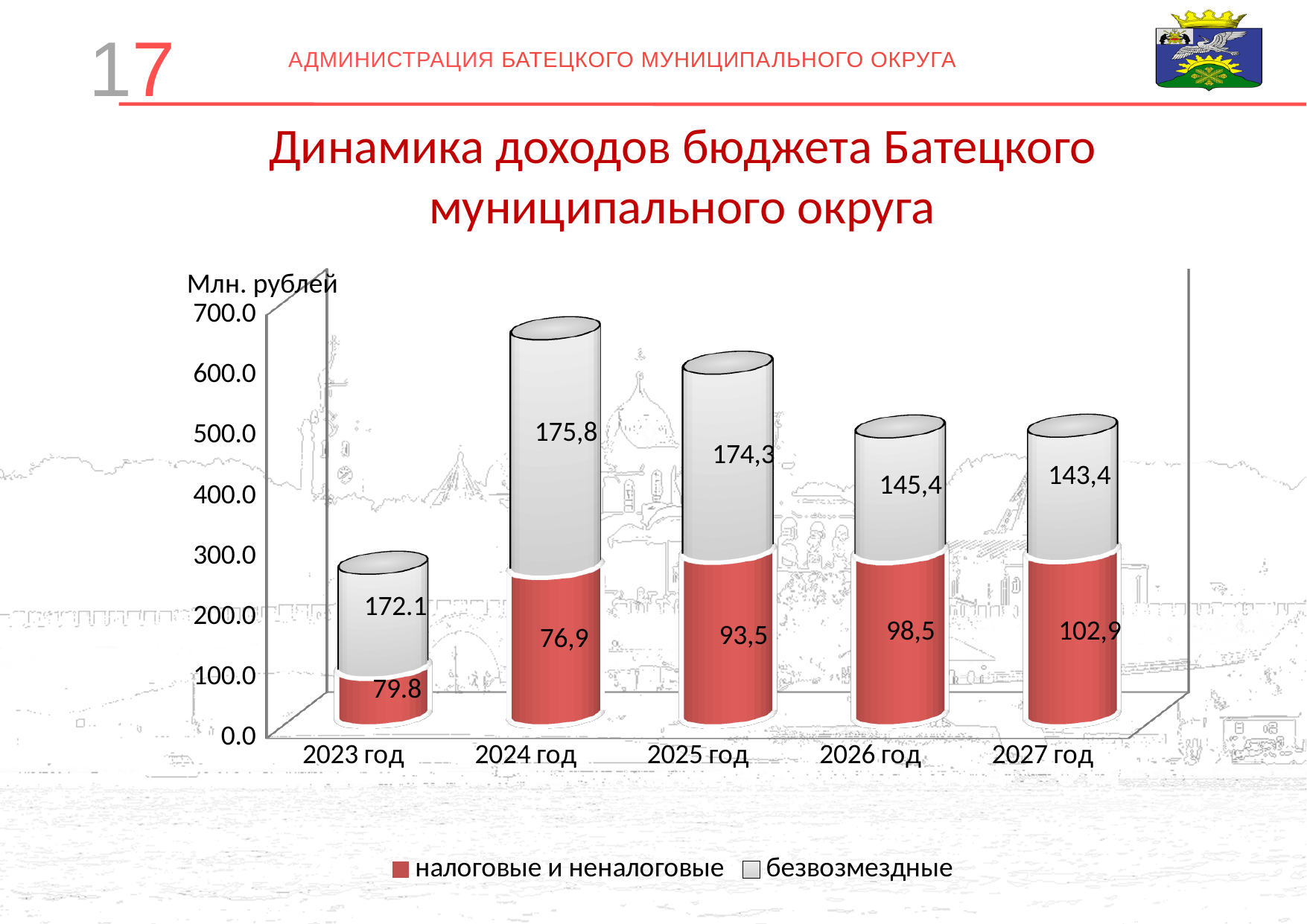
How many series does the legend list? 2 How many years are shown on the x axis? 5 Which is larger: the безвозмездные value for 2025 год or for 2026 год? 2025 год In which year is the безвозмездные value the lowest? 2027 год What is the difference between the налоговые и неналоговые values for 2027 год and 2026 год? 4,4 What kind of chart is shown on the slide? stacked bar chart In which year is the налоговые и неналоговые value the highest? 2027 год What is the value for безвозмездные in 2024 год? 175,8 What is the value for безвозмездные in 2027 год? 143,4 What is the value for налоговые и неналоговые in 2023 год? 79.8 What is the value for налоговые и неналоговые in 2025 год? 93,5 Do the безвозмездные values rise or fall from 2024 год to 2027 год? fall